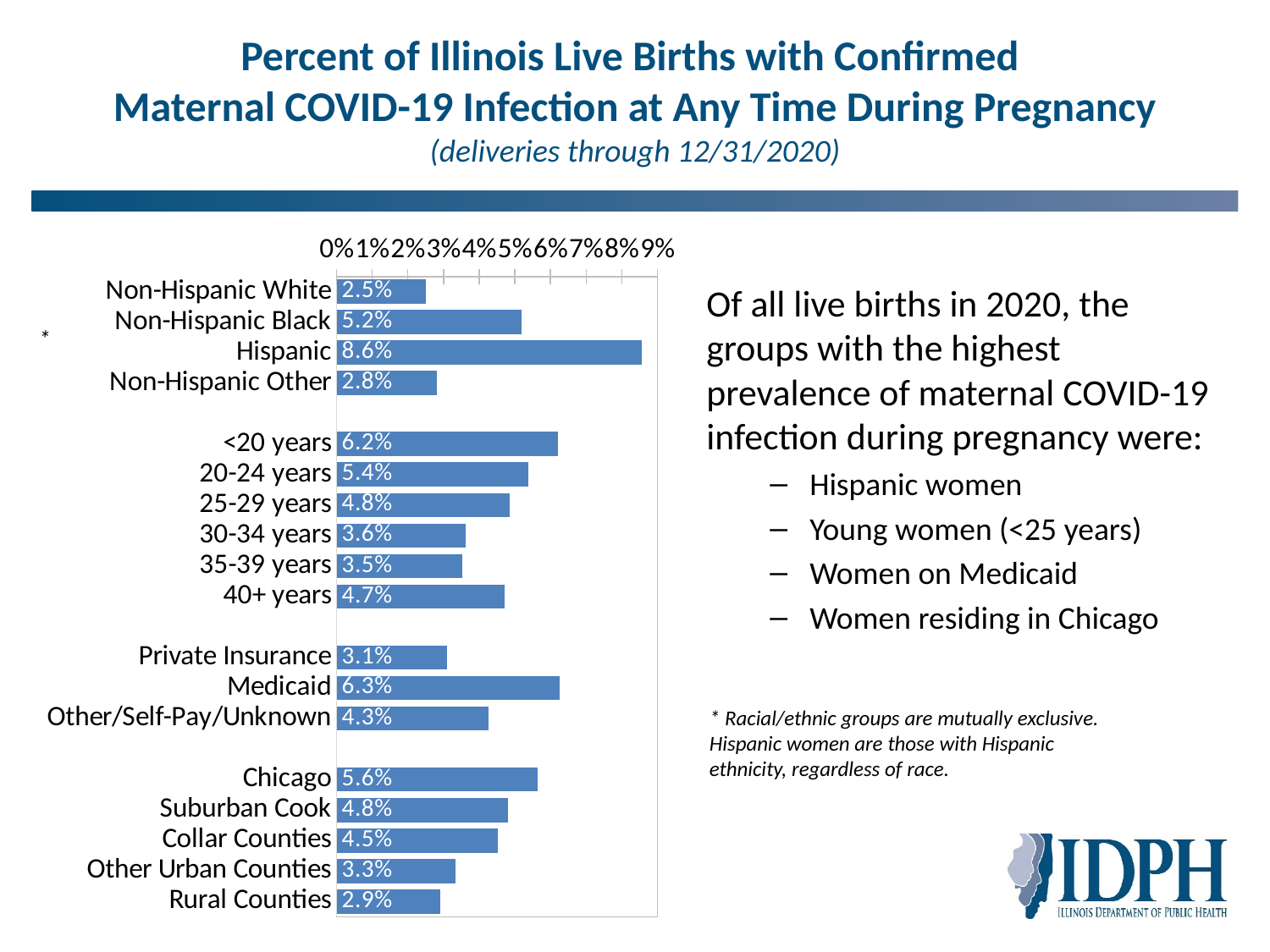
Which category has the highest value? Hispanic Is the value for <20 years greater or less than 5%? greater What kind of chart is shown on the slide? Bar chart Which category has the lowest value? Non-Hispanic White What is the highest value shown on the chart's percentage axis? 9% Do the values rise or fall from <20 years to 35-39 years? Fall What is the value for Hispanic? 8.6% What is the value for Medicaid? 6.3% What is the difference between the values for Medicaid and Private Insurance? 3.2% Which is larger, the value for Chicago or the value for Suburban Cook? Chicago How many bars are plotted in the chart? 18 What is the value for Rural Counties? 2.9%